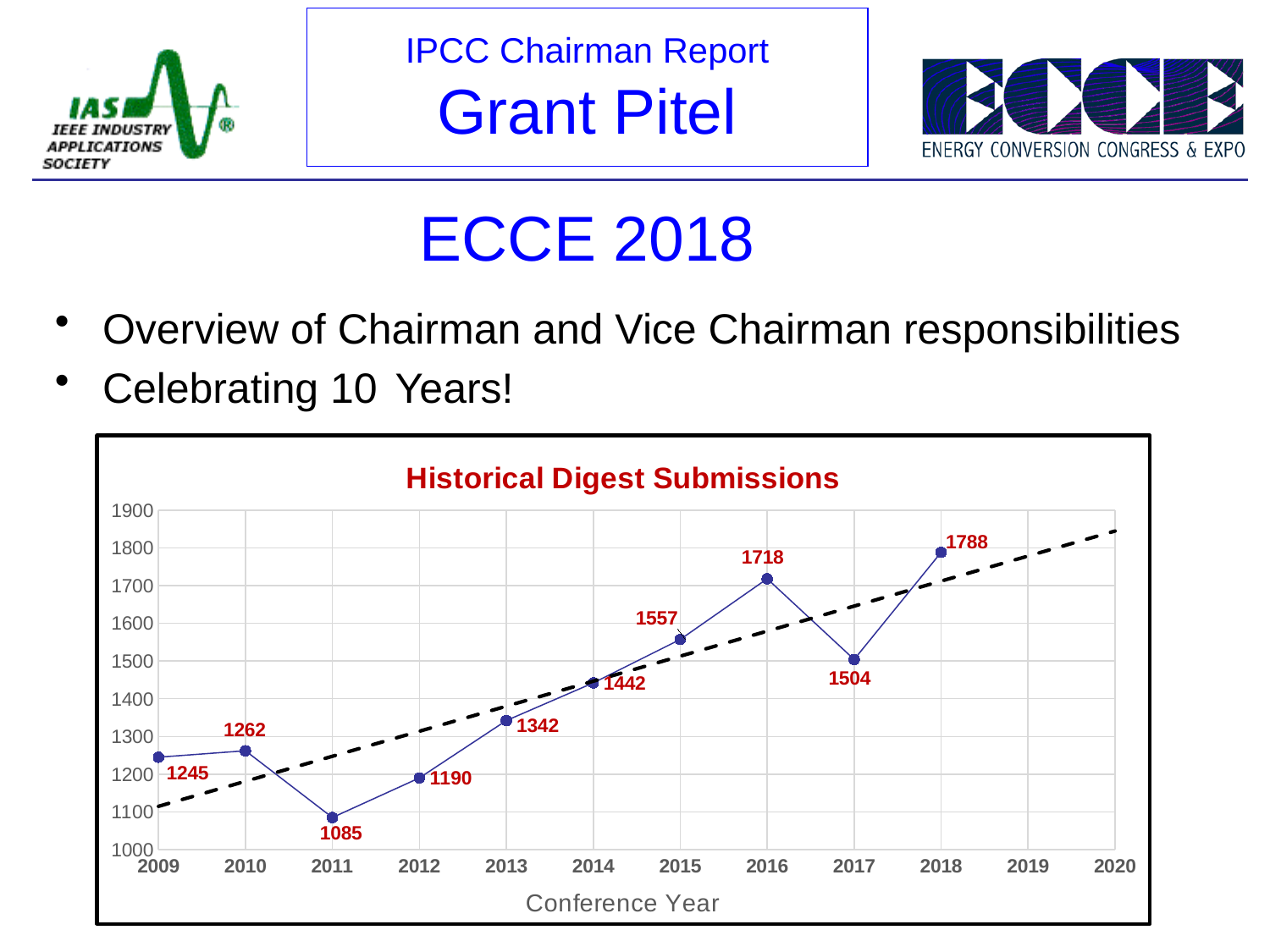
How many digest submissions were there in 2016? 1718 Is the value for 2015 greater or less than 1500? greater What is the title of the chart? Historical Digest Submissions How many data points are plotted on the line? 10 What is the difference between the 2018 and 2017 values? 284 Which year had more submissions, 2010 or 2012? 2010 Which year has the lowest number of digest submissions? 2011 What is the label of the x axis? Conference Year What kind of chart is shown on the slide? line chart Which year has the highest number of digest submissions? 2018 What is the value for 2011? 1085 What is the value for 2018? 1788